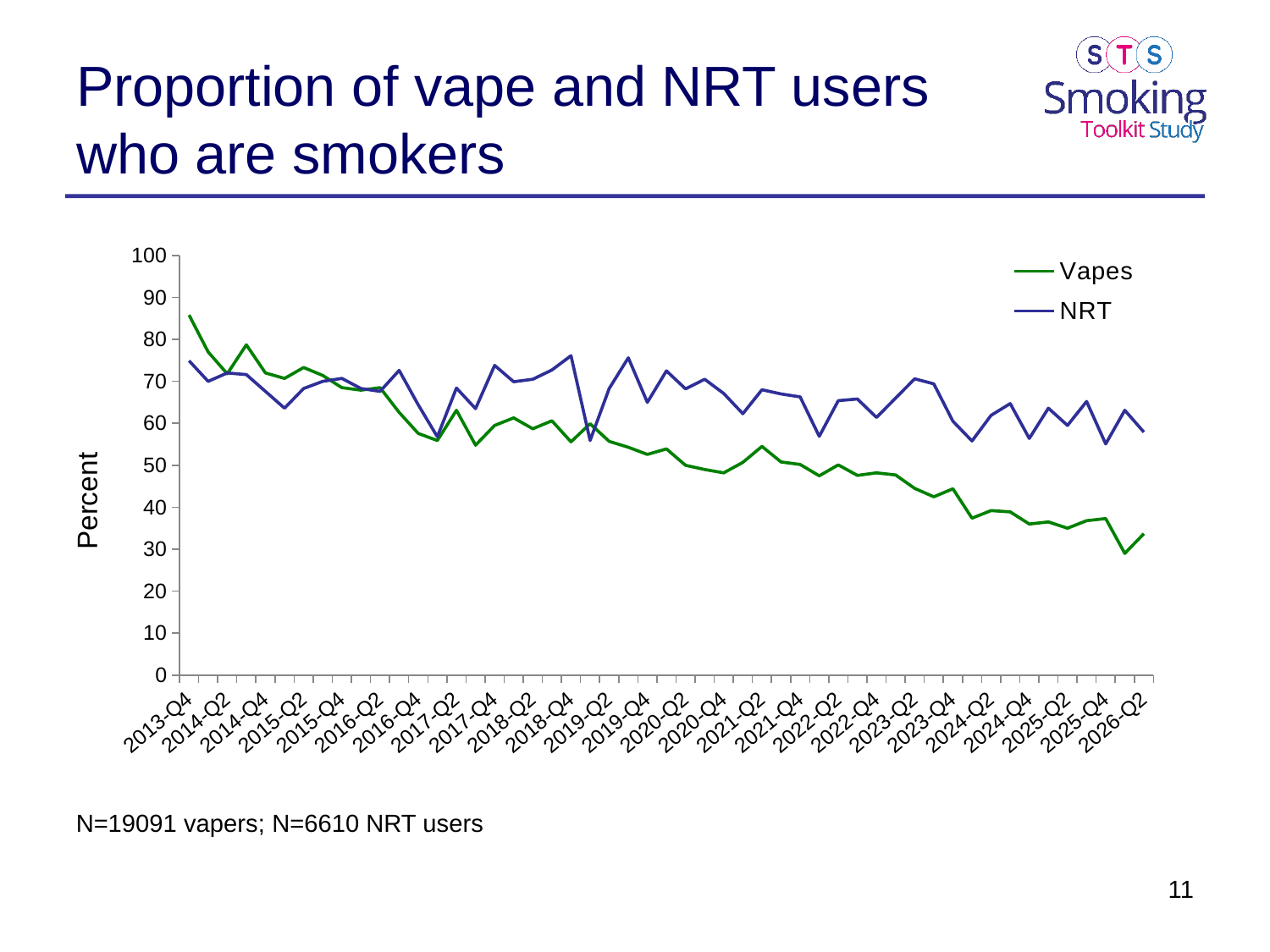
Is the value for NRT at 2026-Q2 greater or less than 50? greater At which labelled quarter does the Vapes series reach its highest value? 2013-Q4 Is the value for Vapes at 2013-Q4 greater or less than 80? greater What kind of chart is shown on the slide? Line chart At 2013-Q4, which series has the higher value, Vapes or NRT? Vapes Do the values for the Vapes series generally rise or fall from 2013-Q4 to 2026-Q2? Fall How many series does the legend list? 2 Is the value for NRT at 2013-Q4 greater or less than 70? greater At 2026-Q2, which series has the higher value, Vapes or NRT? NRT What is the label on the vertical axis? Percent What are the two series named in the legend? Vapes and NRT